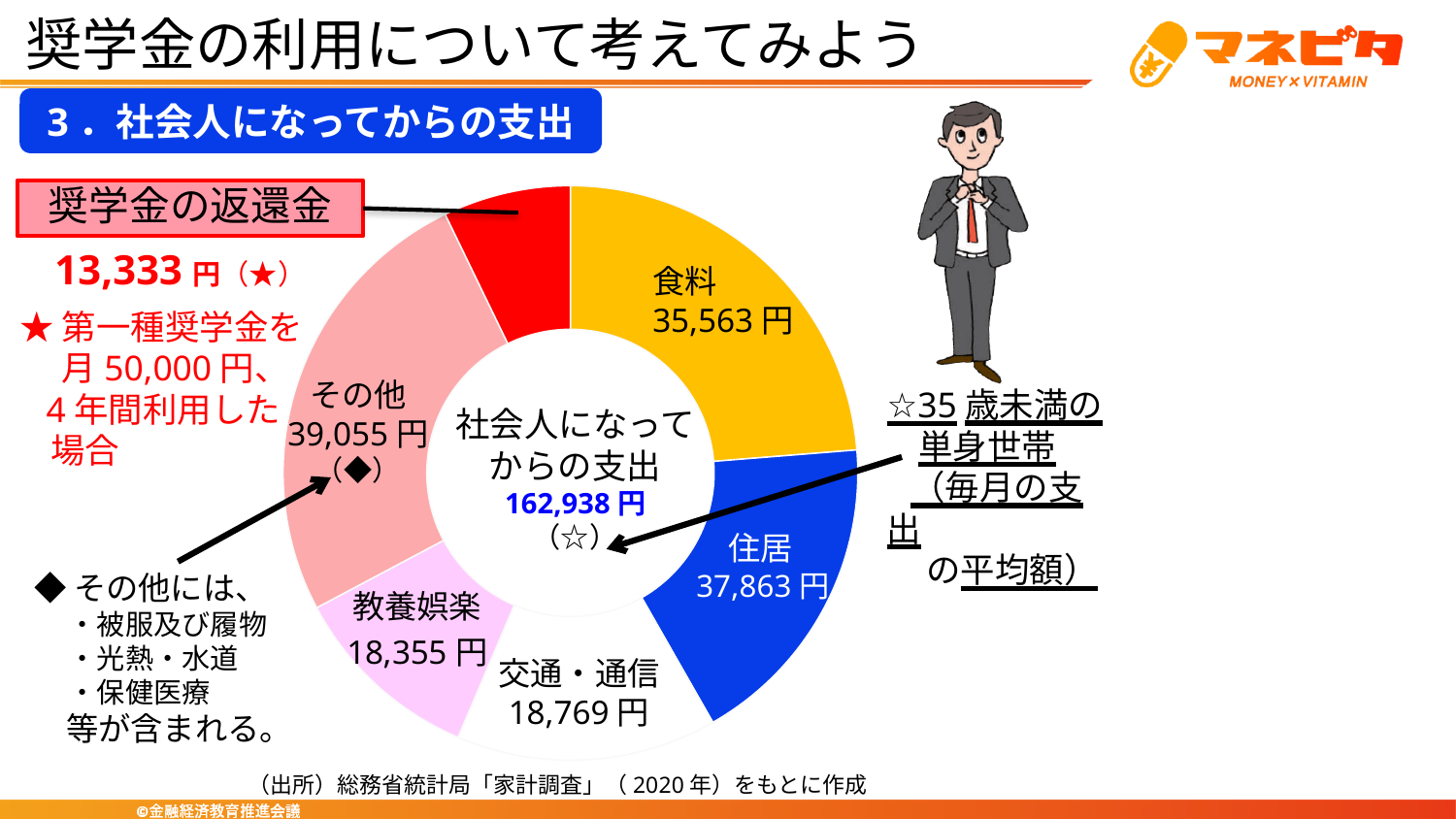
What is the value for 教養娯楽 in the chart? 18,355 円 Which category has the highest value in the chart? その他 Which is larger, 交通・通信 or 教養娯楽? 交通・通信 What kind of chart is shown on the slide? Donut (pie) chart What is the value for 住居 in the chart? 37,863 円 What is the difference between 住居 and 食料? 2,300 円 What is the value for 奨学金の返還金 in the chart? 13,333 円 What is the value for 食料 in the chart? 35,563 円 Which category has the lowest value in the chart? 奨学金の返還金 What is the title shown in the centre of the chart? 社会人になってからの支出 How many categories are shown in the chart? 6 What is the total of all categories shown in the centre of the chart? 162,938 円